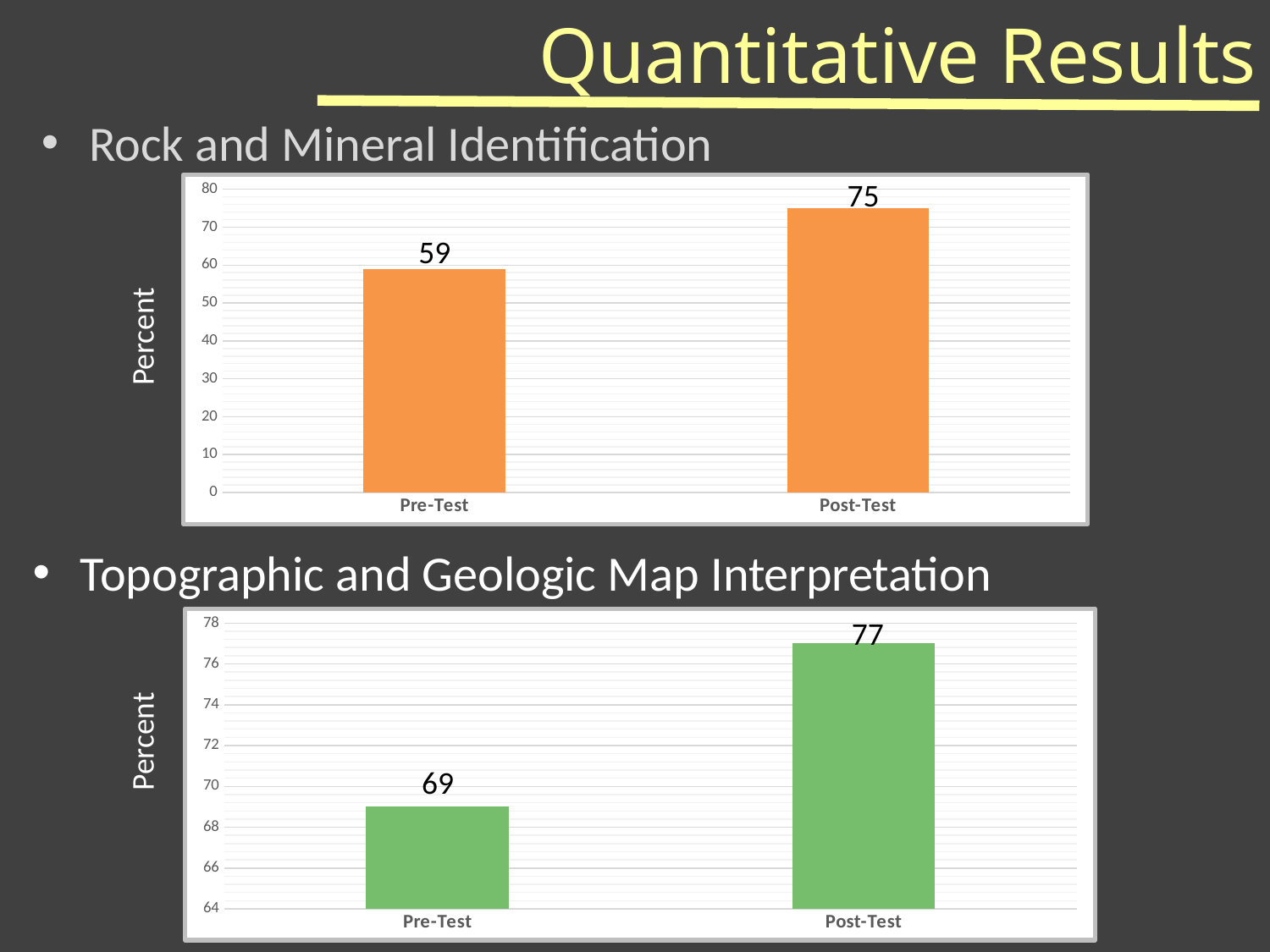
In the Topographic and Geologic Map Interpretation chart, what is the value for Post-Test? 77 In the Topographic and Geologic Map Interpretation chart, what is the value for Pre-Test? 69 What is the y-axis label on the Topographic and Geologic Map Interpretation chart? Percent In the Rock and Mineral Identification chart, what is the value for Pre-Test? 59 How many categories are shown in the Topographic and Geologic Map Interpretation chart? 2 In the Rock and Mineral Identification chart, what is the value for Post-Test? 75 In the Topographic and Geologic Map Interpretation chart, which category has the lower value? Pre-Test In the Rock and Mineral Identification chart, is the Pre-Test value greater or less than 60? less In the Topographic and Geologic Map Interpretation chart, what is the difference between the Post-Test and Pre-Test values? 8 What kind of chart is the Rock and Mineral Identification chart? bar chart In the Rock and Mineral Identification chart, what is the difference between the Post-Test and Pre-Test values? 16 In the Rock and Mineral Identification chart, which category has the higher value? Post-Test